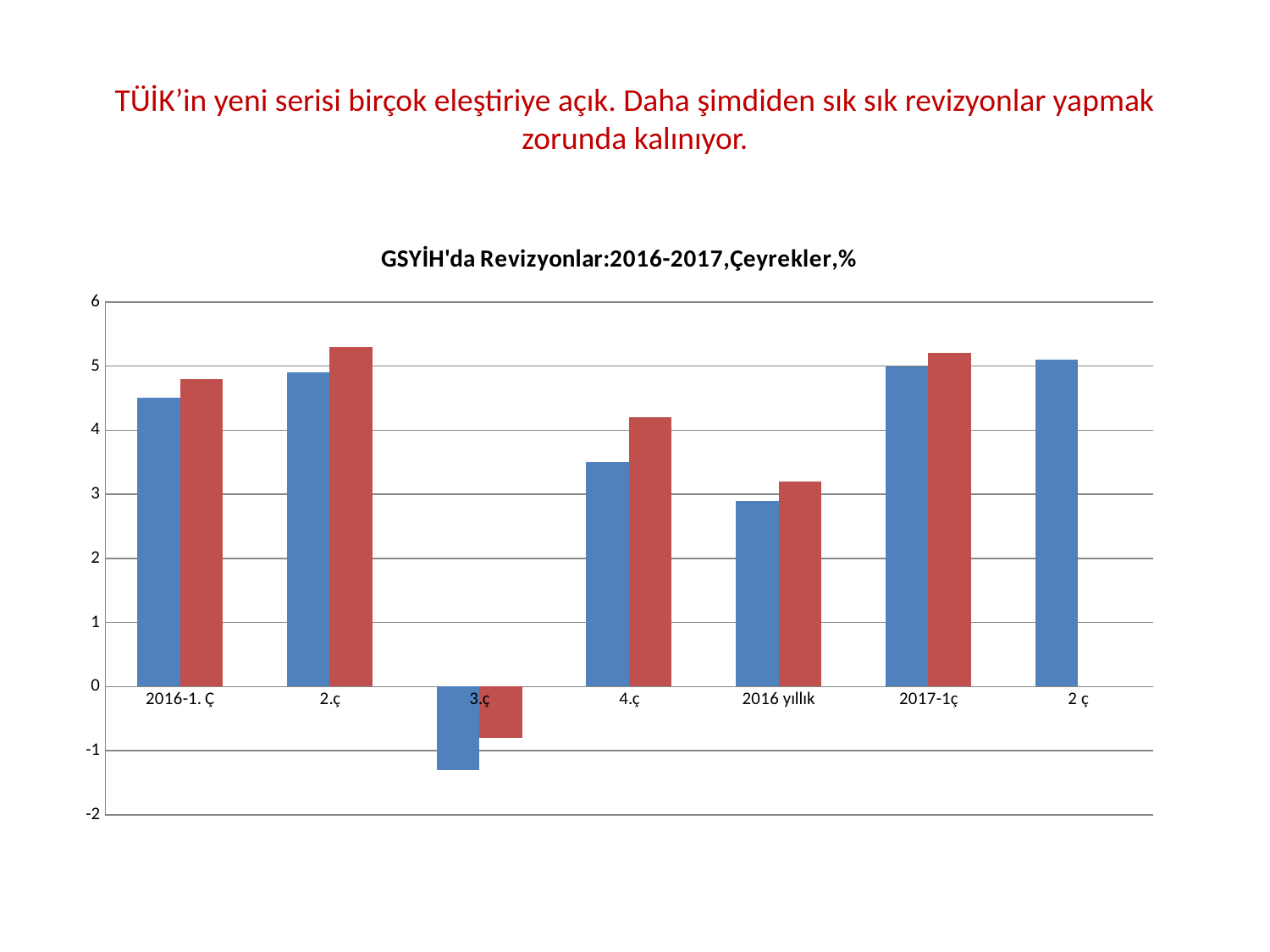
Is the value of the blue bar for 2016 yıllık greater or less than 3? less Is the value of the red bar for 4.ç greater or less than 4? greater What type of chart is shown on the slide? bar chart For 4.ç, which bar is larger, the blue bar or the red bar? the red bar Which category has the lowest value in the chart? 3.ç Which category has only a blue bar and no red bar? 2 ç Is the value of the blue bar for 2016-1. Ç greater or less than 4? greater How many categories are shown on the x axis of the chart? 7 What is the title of the chart? GSYİH'da Revizyonlar:2016-2017,Çeyrekler,%